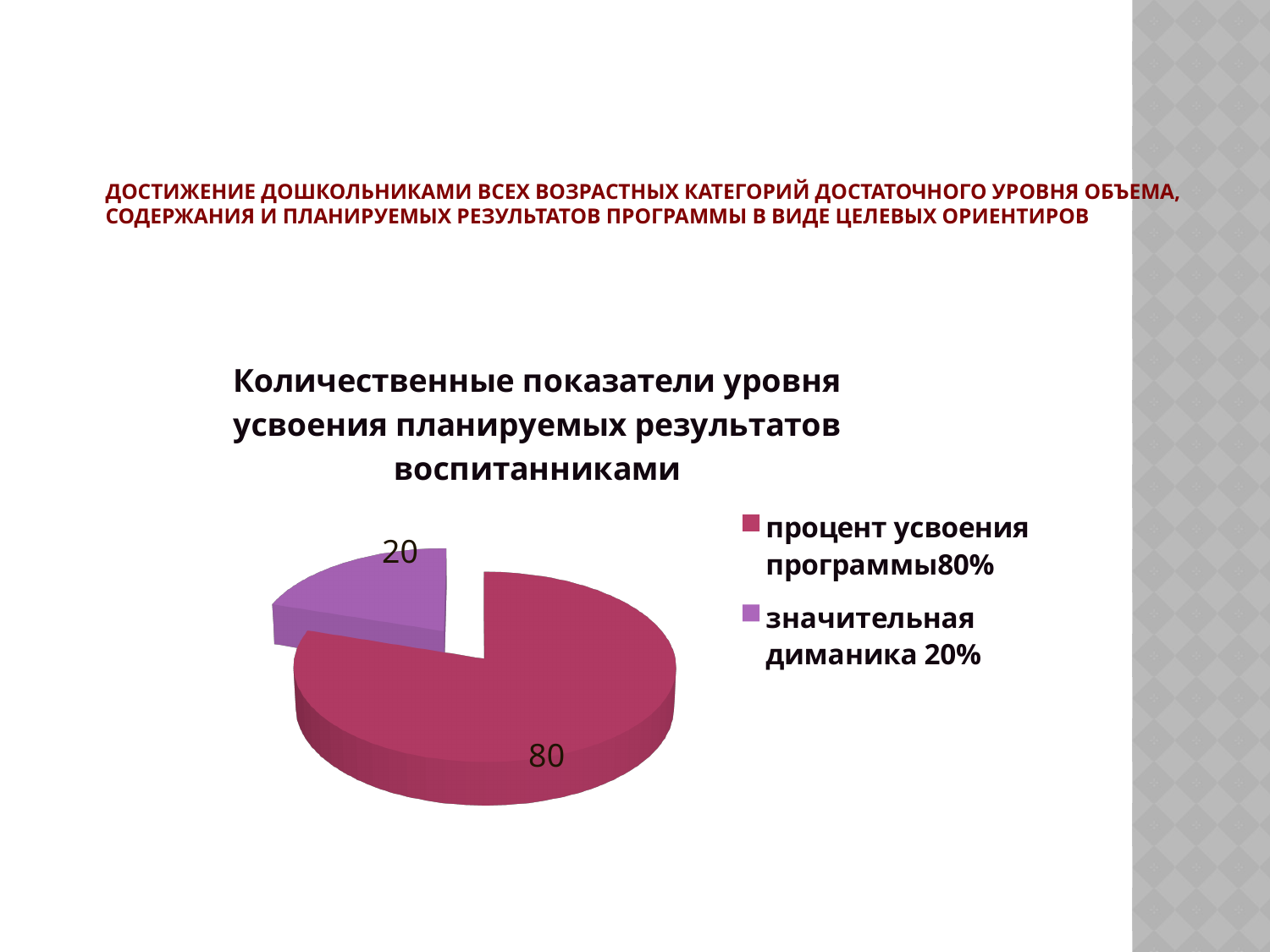
How many entries does the legend list? 2 What is the title of the chart? Количественные показатели уровня усвоения планируемых результатов воспитанниками What is the data label on the slice for "значительная диманика 20%"? 20 What is the difference between the two slice values shown on the pie chart? 60 How many slices does the pie chart have? 2 Which slice of the pie chart is the smallest? значительная диманика 20% What share of the pie does the "значительная диманика 20%" slice represent? 20% Which slice of the pie chart is the largest? процент усвоения программы80% What is the data label on the slice for "процент усвоения программы80%"? 80 Which is larger: the slice for "процент усвоения программы80%" or the slice for "значительная диманика 20%"? процент усвоения программы80% What colour is the slice labelled 20? purple What type of chart is shown on the slide? pie chart